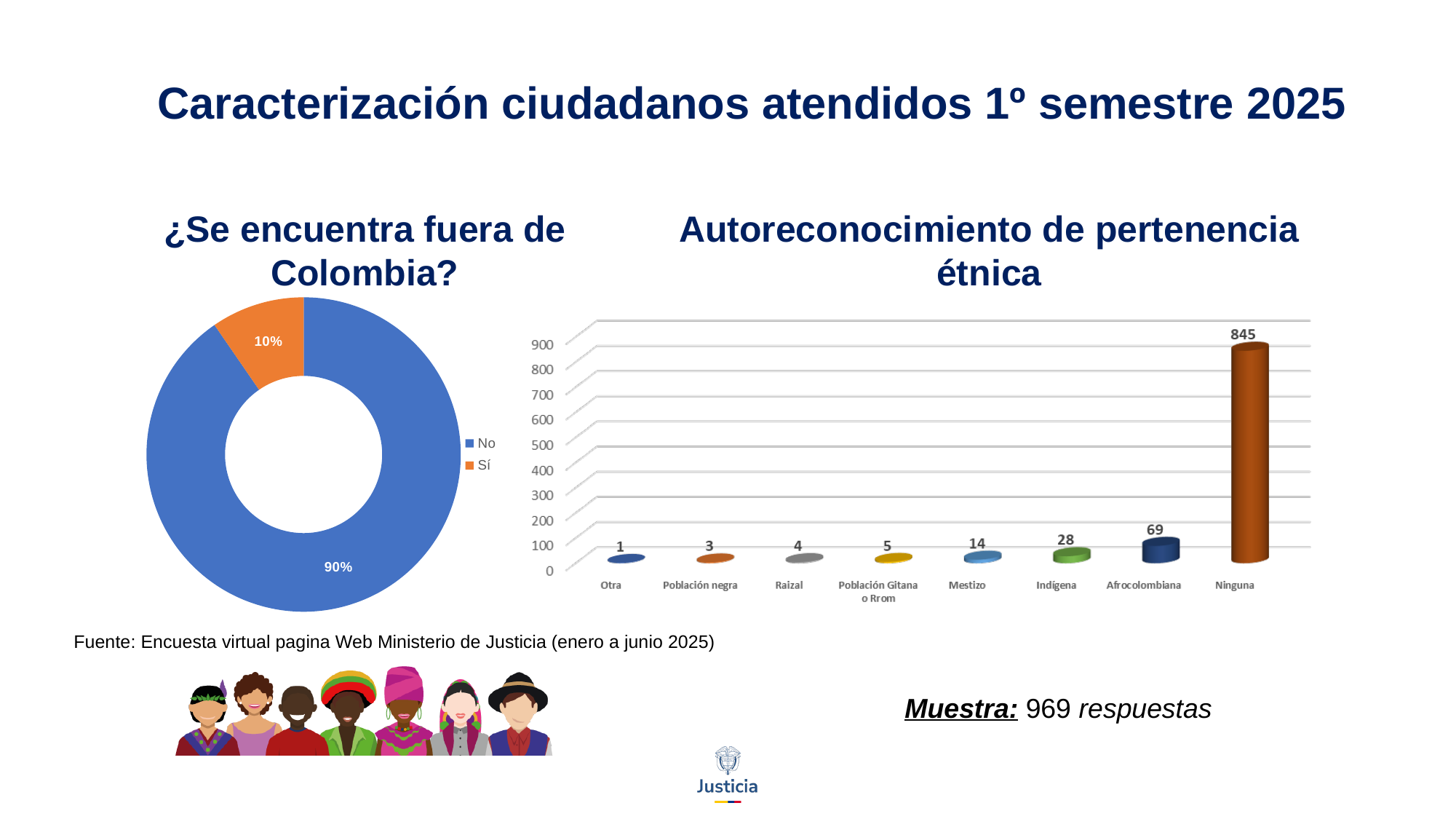
What kind of chart is the '¿Se encuentra fuera de Colombia?' chart? Doughnut (pie) chart In the 'Autoreconocimiento de pertenencia étnica' chart, how many categories are shown on the x axis? 8 In the 'Autoreconocimiento de pertenencia étnica' chart, what is the value for Ninguna? 845 In the '¿Se encuentra fuera de Colombia?' chart, what percentage answered 'No'? 90% In the 'Autoreconocimiento de pertenencia étnica' chart, what is the value for Afrocolombiana? 69 How many entries does the legend of the '¿Se encuentra fuera de Colombia?' chart list? 2 In the 'Autoreconocimiento de pertenencia étnica' chart, which category has the lowest value? Otra In the 'Autoreconocimiento de pertenencia étnica' chart, which category has the highest value? Ninguna In the 'Autoreconocimiento de pertenencia étnica' chart, which is larger: Mestizo or Raizal? Mestizo In the '¿Se encuentra fuera de Colombia?' chart, what percentage answered 'Sí'? 10% In the 'Autoreconocimiento de pertenencia étnica' chart, what is the value for Indígena? 28 In the 'Autoreconocimiento de pertenencia étnica' chart, what is the difference between Ninguna and Afrocolombiana? 776